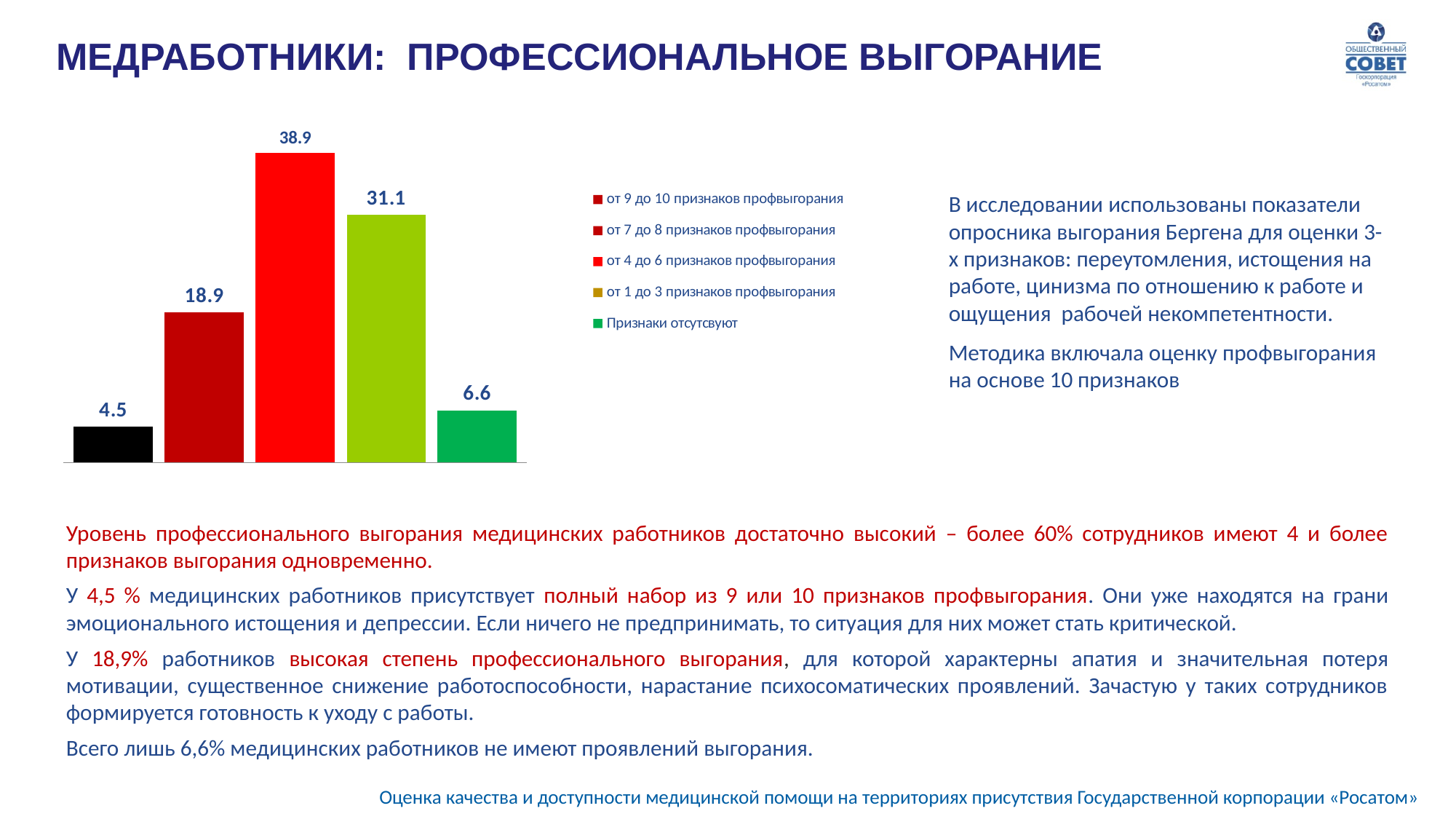
What is the value for 'от 4 до 6 признаков профвыгорания'? 38.9 How many bars are plotted in the chart? 5 How many entries does the chart legend list? 5 What type of chart is shown on the slide? bar chart Which category has the lowest value? от 9 до 10 признаков профвыгорания What is the value for 'от 9 до 10 признаков профвыгорания'? 4.5 Which is larger: the value for 'от 7 до 8 признаков профвыгорания' or for 'Признаки отсутсвуют'? от 7 до 8 признаков профвыгорания Which category has the highest value? от 4 до 6 признаков профвыгорания What is the value for 'от 1 до 3 признаков профвыгорания'? 31.1 What is the value for 'Признаки отсутсвуют'? 6.6 What is the value for 'от 7 до 8 признаков профвыгорания'? 18.9 What is the difference between the values for 'от 4 до 6 признаков профвыгорания' and 'от 1 до 3 признаков профвыгорания'? 7.8